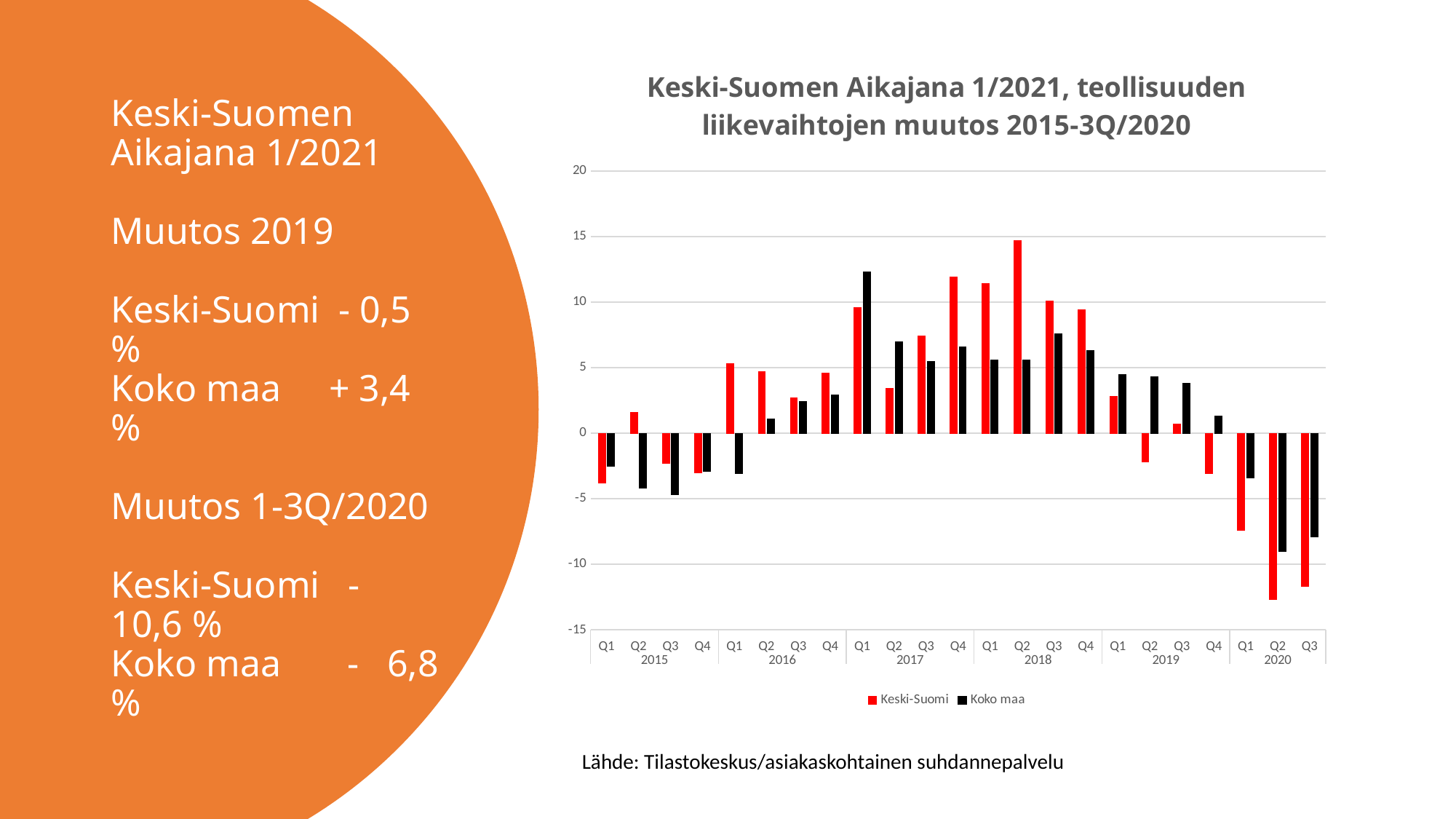
Which series is shown in red in the legend? Keski-Suomi What kind of chart is shown on the slide? bar chart In which quarter does the Keski-Suomi series reach its lowest value? Q2 2020 How many series does the legend list? 2 In Q4 2017, which series has the larger value, Keski-Suomi or Koko maa? Keski-Suomi Is the Koko maa value for Q2 2020 greater or less than -5? less In which quarter does the Keski-Suomi series reach its highest value? Q2 2018 How many quarters are plotted on the x axis? 23 In which quarter does the Koko maa series reach its highest value? Q1 2017 In Q1 2017, which series has the larger value, Keski-Suomi or Koko maa? Koko maa In which quarter does the Koko maa series reach its lowest value? Q2 2020 Is the Keski-Suomi value for Q2 2018 greater or less than 10? greater